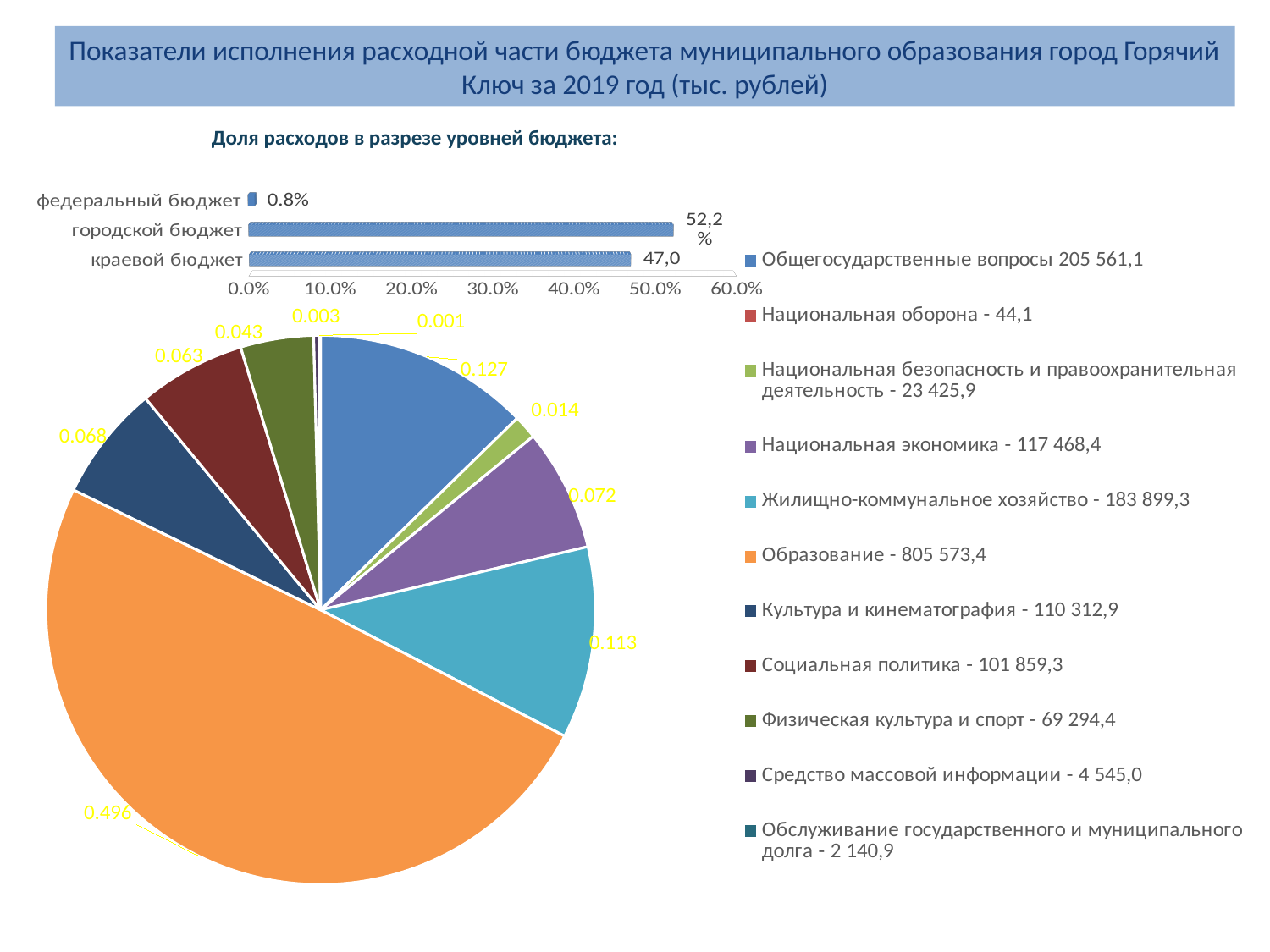
What kind of chart is the chart titled "Доля расходов в разрезе уровней бюджета:"? bar chart In the pie chart legend, what value is given for Жилищно-коммунальное хозяйство? 183 899,3 What kind of chart is the large chart at the bottom of the slide? pie chart How many categories are shown in the chart "Доля расходов в разрезе уровней бюджета:"? 3 In the chart "Доля расходов в разрезе уровней бюджета:", which category has the lowest value? федеральный бюджет In the pie chart, what share is labelled on the Образование slice? 0.496 How many entries does the legend of the pie chart list? 11 In the chart "Доля расходов в разрезе уровней бюджета:", what is the value for городской бюджет? 52,2% In the chart "Доля расходов в разрезе уровней бюджета:", which category has the highest value? городской бюджет In the chart "Доля расходов в разрезе уровней бюджета:", what is the value for федеральный бюджет? 0.8% In the pie chart, which category has the largest slice? Образование In the chart "Доля расходов в разрезе уровней бюджета:", is the value for краевой бюджет greater or less than 40.0%? greater